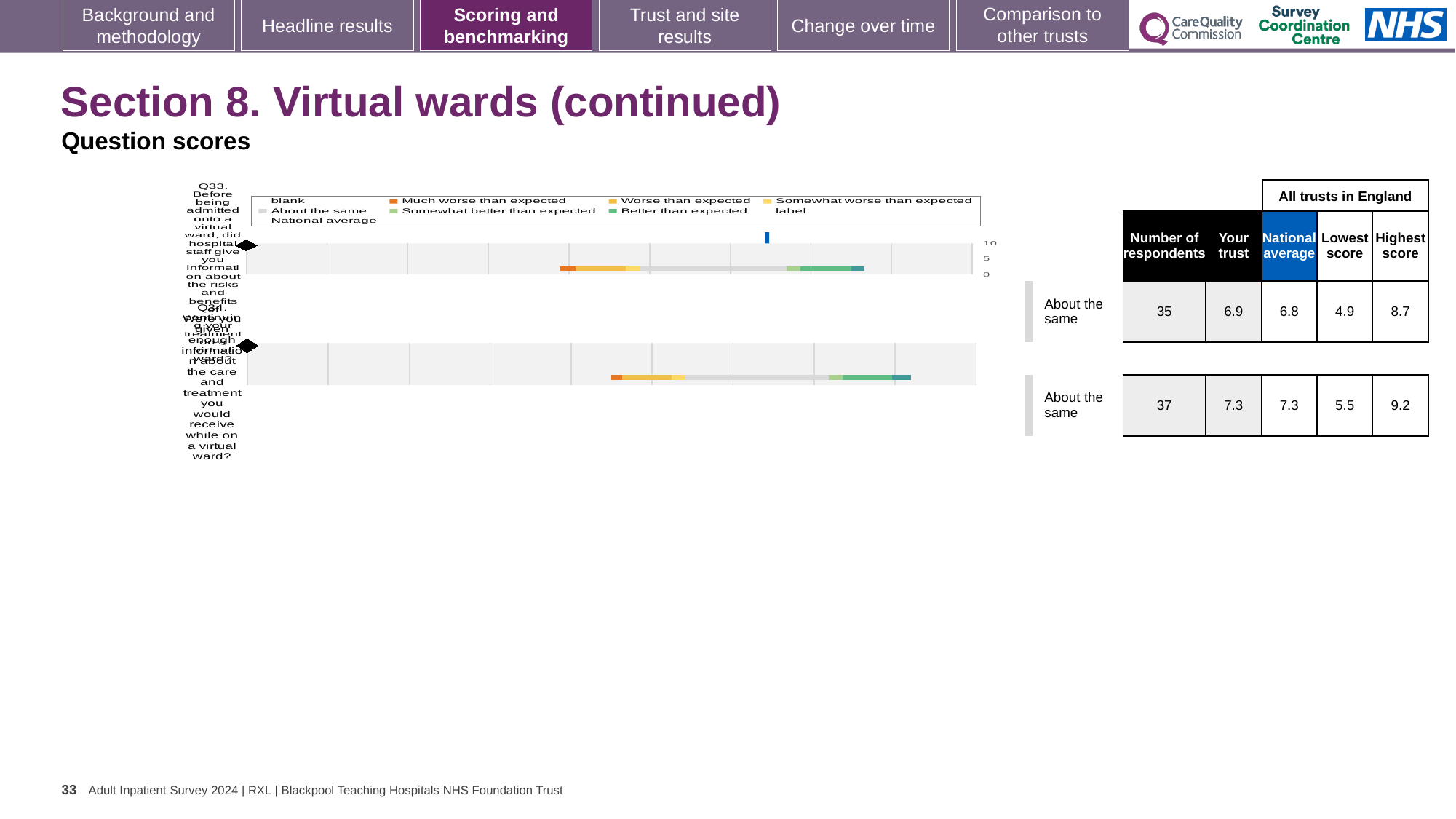
What benchmark category is shown for Q34? About the same Which question has more respondents, Q33 or Q34? Q34 Which colour in the legend represents 'Much worse than expected'? orange What is the difference between the highest and lowest scores for Q33? 3.8 What is the national average score for Q34? 7.3 What is the lowest score among all trusts in England for Q33? 4.9 Which colour in the legend represents 'Better than expected'? green What is the 'Your trust' score for Q33? 6.9 What is the number of respondents for Q33? 35 How many question bars are plotted in the chart? 2 What kind of chart is shown on the slide? bar chart What is the highest score among all trusts in England for Q34? 9.2